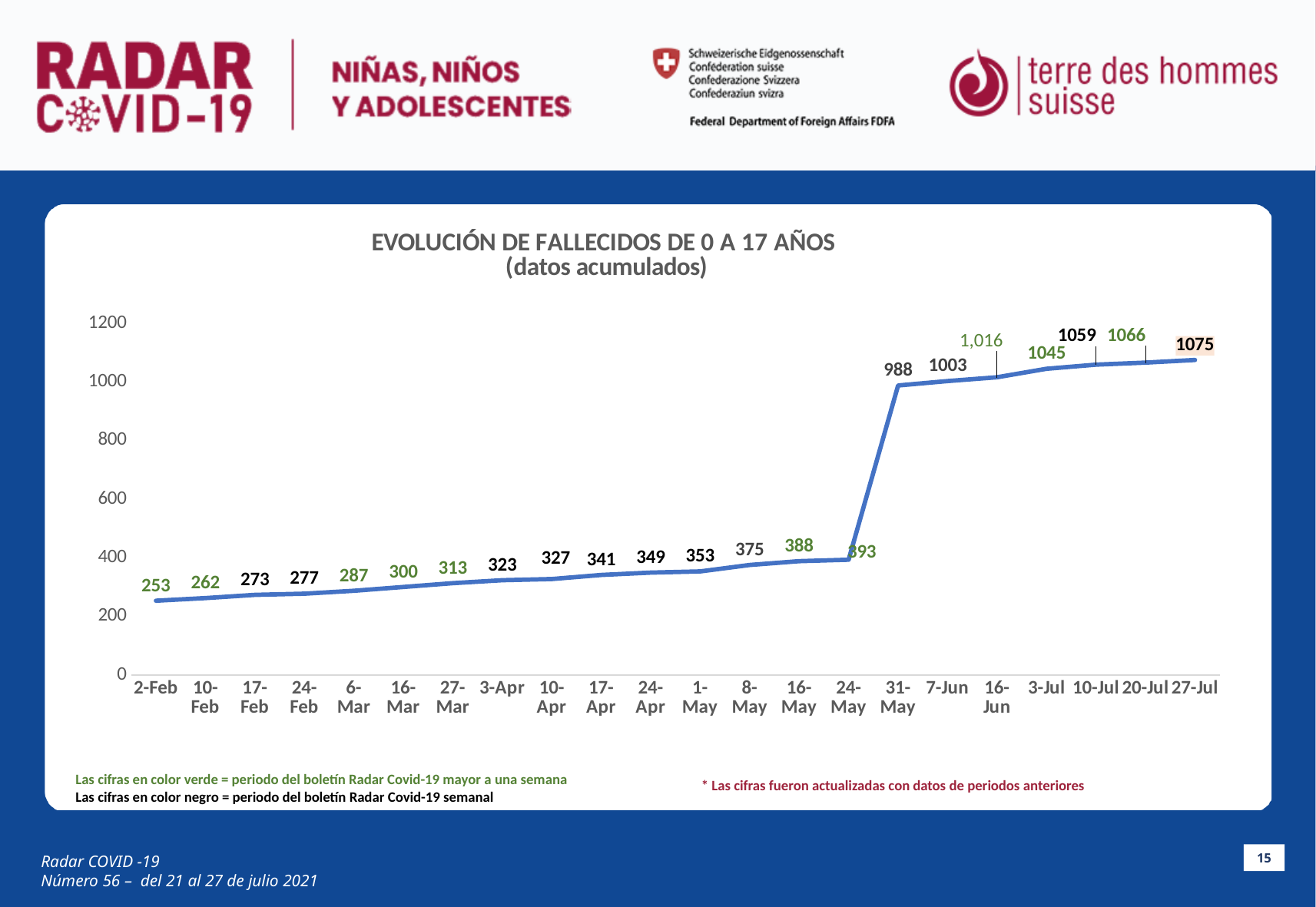
What is the difference between the values for 31-May and 24-May? 595 What kind of chart is shown on the slide? Line chart Which is larger, the value for 16-May or the value for 8-May? 16-May Which date has the highest value? 27-Jul What is the value for 2-Feb? 253 What is the value for 27-Jul? 1075 Which date has the lowest value? 2-Feb Do the values rise or fall from 2-Feb to 27-Jul? Rise How many data points are plotted on the chart? 22 What is the difference between the values for 27-Jul and 2-Feb? 822 What is the value for 16-Jun? 1,016 What is the value for 31-May? 988